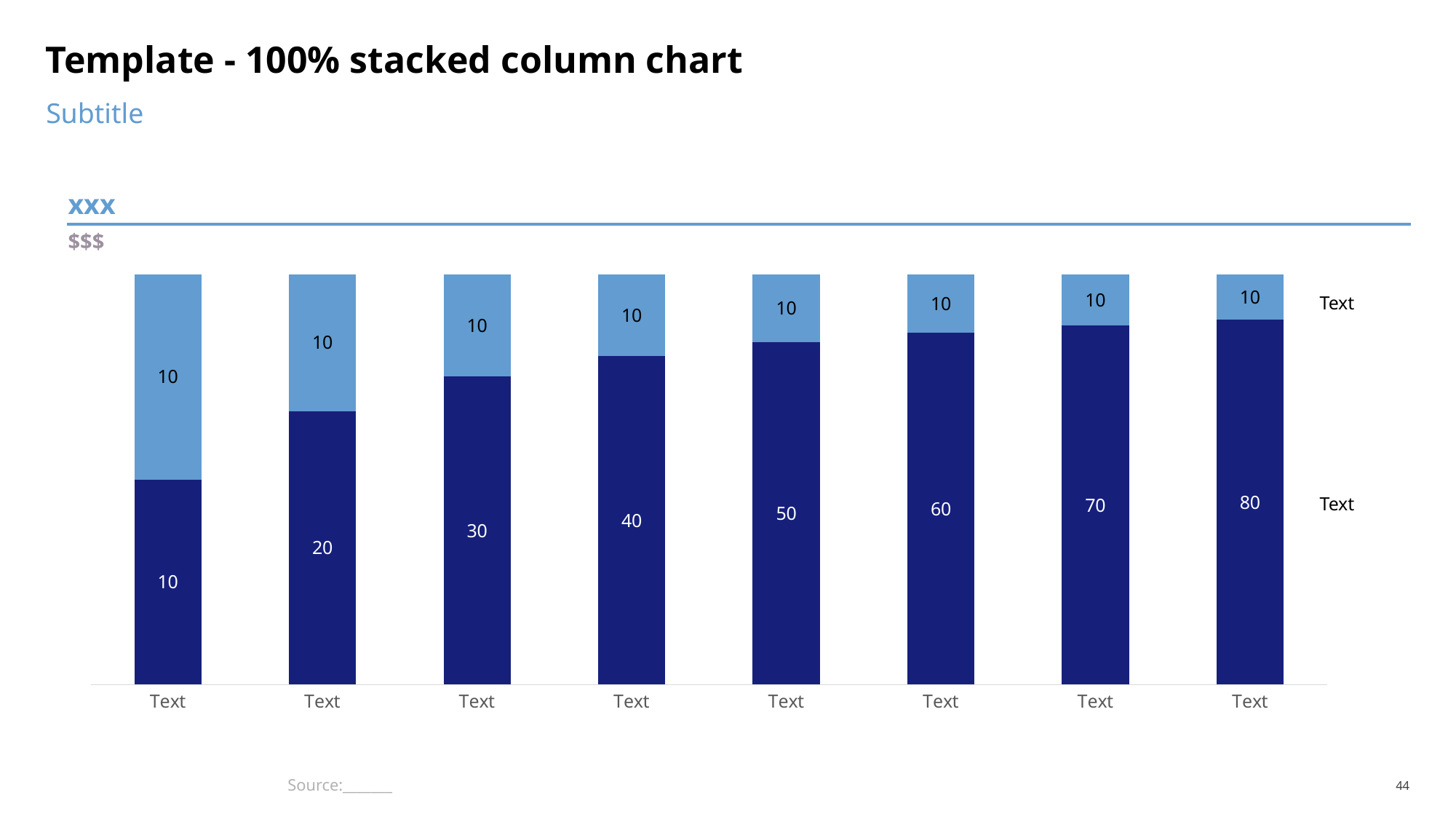
Do the dark blue segment values rise or fall from left to right across the bars? rise What kind of chart is shown on the slide? bar chart What is the value of the dark blue segment in the rightmost bar? 80 What is the difference between the dark blue values of the rightmost bar and the leftmost bar? 70 What is the total of the two segments in the rightmost bar? 90 Which bar has the smallest dark blue segment value? the leftmost (first) bar What is the value of the dark blue segment in the leftmost bar? 10 Which bar has the largest dark blue segment value? the rightmost (eighth) bar Which is larger: the dark blue value of the fifth bar or the dark blue value of the third bar? the fifth bar What is the value of the light blue segment in the fourth bar from the left? 10 How many bars are plotted in the chart? 8